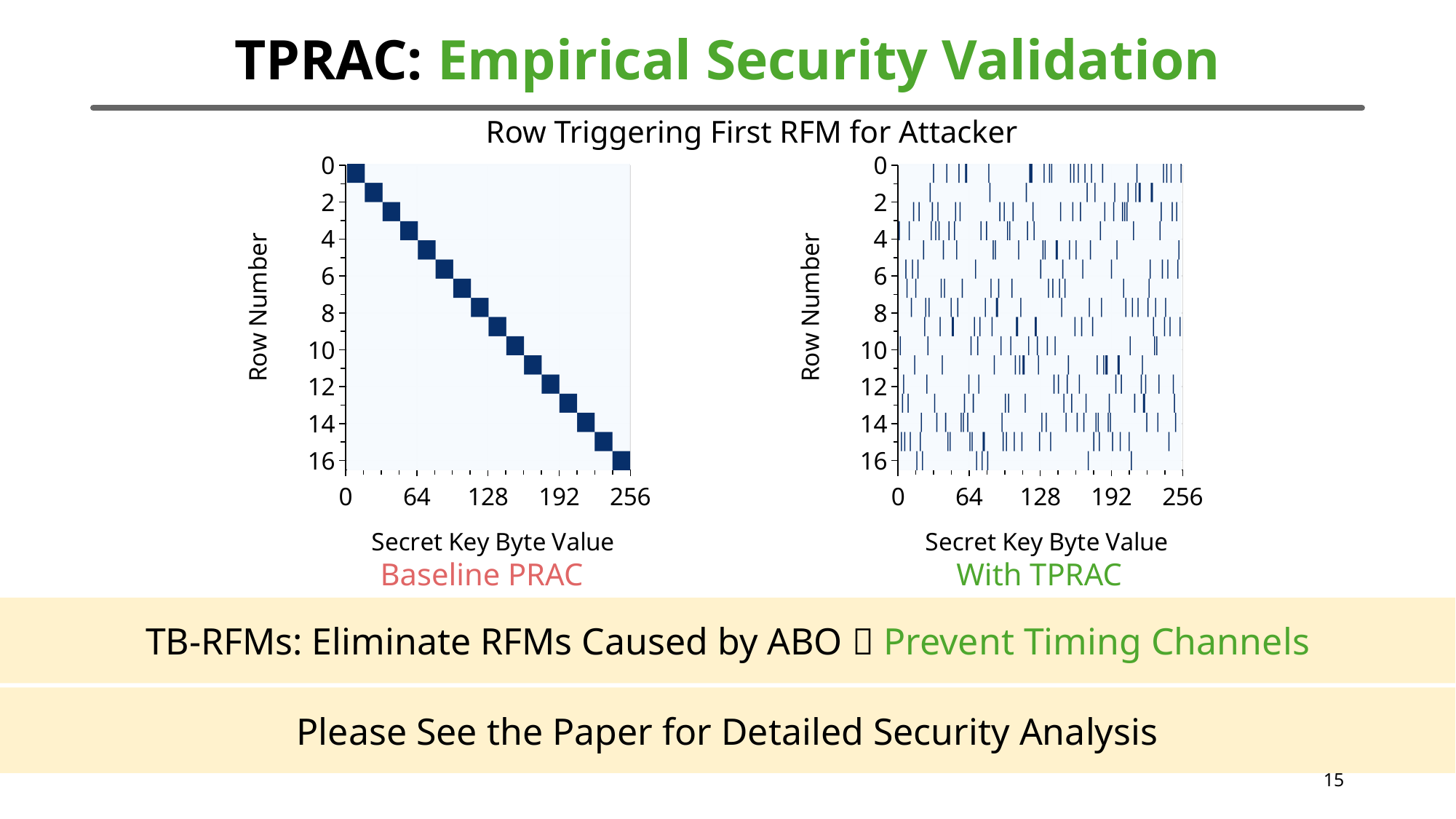
In the Baseline PRAC chart, which row number is triggered for a secret key byte value of 128? 8 Which chart shows a clear diagonal pattern from row 0 to row 16, Baseline PRAC or With TPRAC? Baseline PRAC In the Baseline PRAC chart, does the row number rise or fall as the secret key byte value increases along the x axis? rise In the Baseline PRAC chart, which row number is triggered for a secret key byte value of 256? 16 What is the highest row number shown on the y axis of the With TPRAC chart? 16 How many charts are shown on the slide? 2 What is the largest secret key byte value shown on the x axis of the With TPRAC chart? 256 What is the overall title shared by the two charts on the slide? Row Triggering First RFM for Attacker In the With TPRAC chart, do the marks follow a single rising diagonal or appear scattered across all rows? scattered across all rows What is the label of the x axis on the Baseline PRAC chart? Secret Key Byte Value In the Baseline PRAC chart, which row number is triggered for a secret key byte value of 0? 0